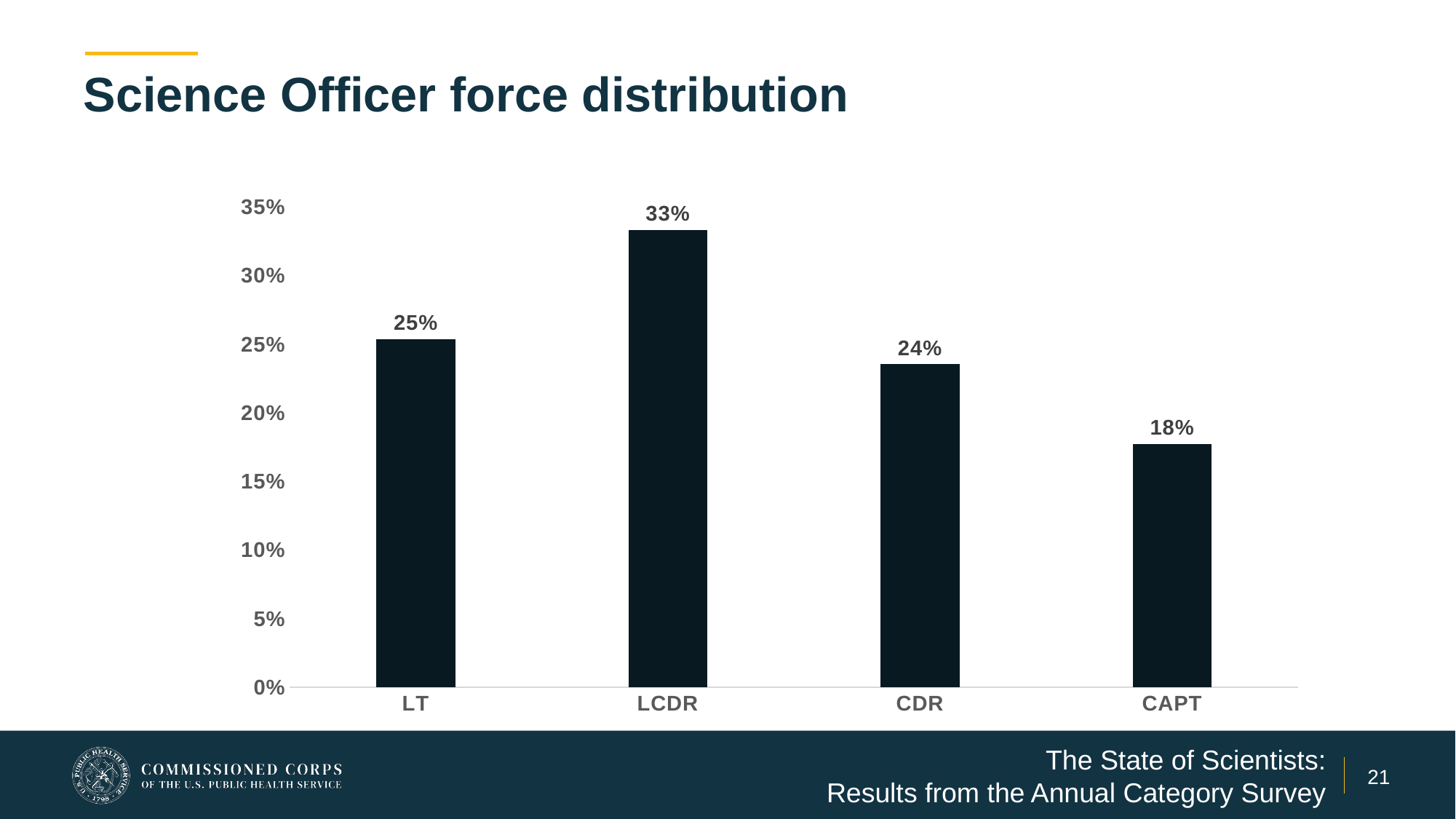
What is the value for CDR? 24% What is the title of the slide containing the chart? Science Officer force distribution How many categories are shown on the x axis? 4 Is the value for LCDR greater or less than 30%? greater Which category has the highest value? LCDR What is the value for LT? 25% Which category has the lowest value? CAPT What is the value for CAPT? 18% What kind of chart is shown on the slide? bar chart What is the difference between the values for LCDR and CAPT? 15% Which is larger, the value for LT or the value for CAPT? LT What is the value for LCDR? 33%